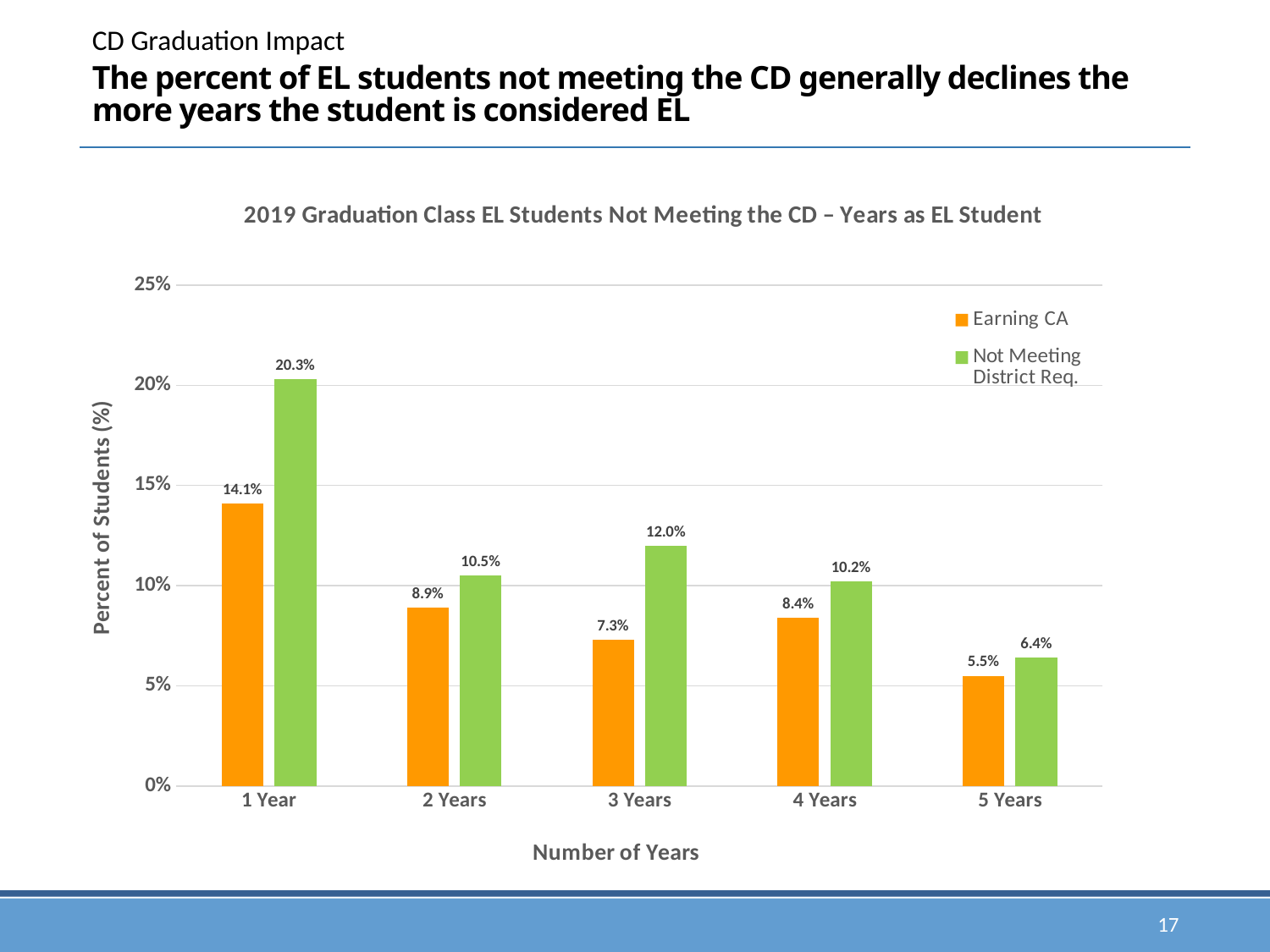
What is the value for Not Meeting District Req. at 3 Years? 12.0% What is the value for Earning CA at 1 Year? 14.1% Which is larger at 4 Years: Earning CA or Not Meeting District Req.? Not Meeting District Req. What is the value for Earning CA at 5 Years? 5.5% Does the Not Meeting District Req. series generally rise or fall from 1 Year to 5 Years? Fall What is the title of the chart? 2019 Graduation Class EL Students Not Meeting the CD – Years as EL Student How many categories are shown on the x axis? 5 What is the difference between Not Meeting District Req. and Earning CA at 1 Year? 6.2% What kind of chart is shown? Bar chart How many series does the legend list? 2 Which category has the highest value for Not Meeting District Req.? 1 Year Which category has the lowest value for Earning CA? 5 Years